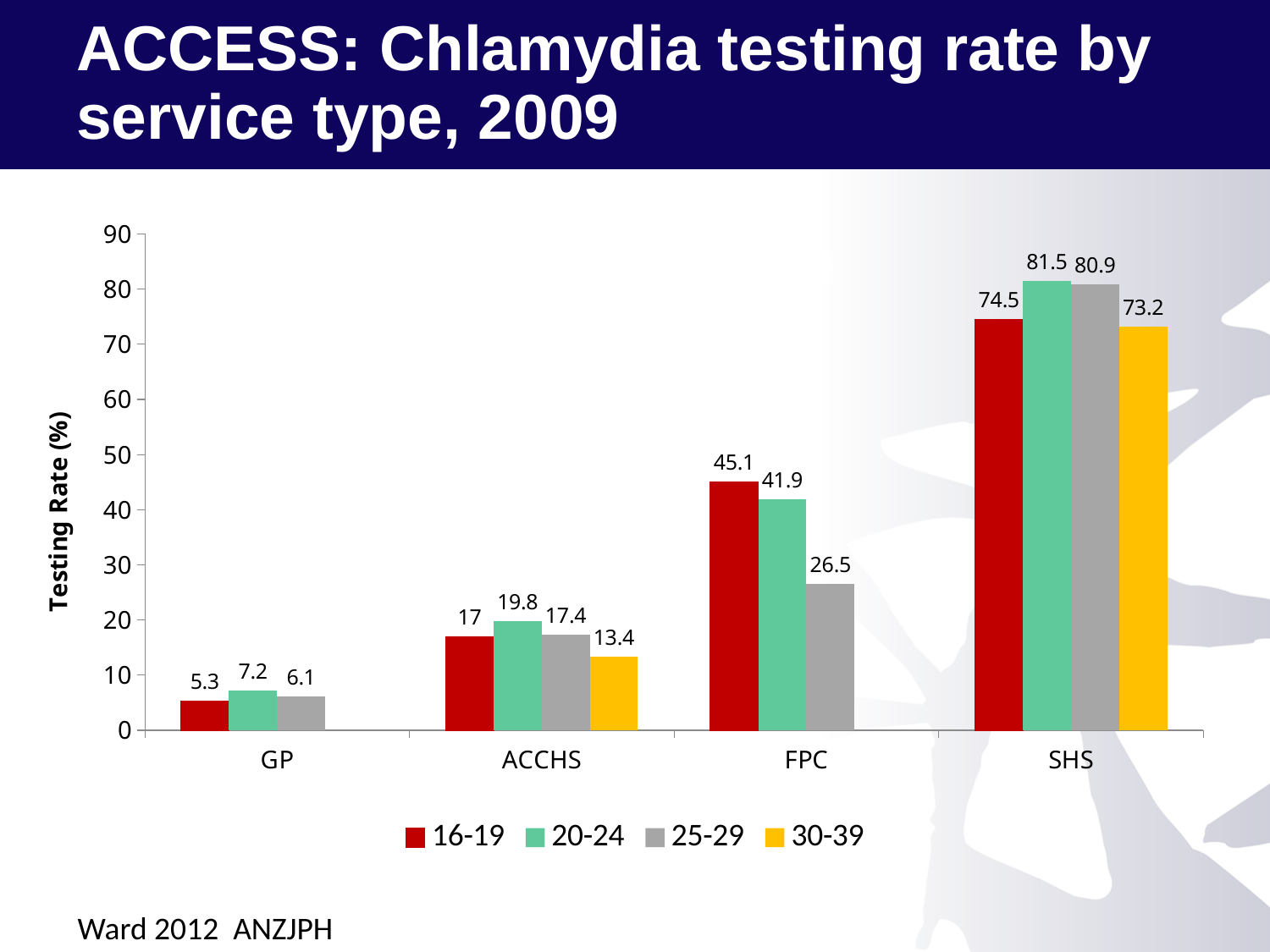
What is the testing rate for the 25-29 age group at FPC? 26.5 Which is larger at ACCHS: the testing rate for 20-24 or for 25-29? 20-24 What is the testing rate for the 16-19 age group at SHS? 74.5 Which service type has the highest testing rate for the 20-24 age group? SHS Which service type has the lowest testing rate for the 16-19 age group? GP What is the label of the y axis? Testing Rate (%) How many age groups does the legend list? 4 What is the difference between the 16-19 and 20-24 testing rates at FPC? 3.2 What type of chart is shown on the slide? Bar chart Is the testing rate for the 30-39 age group at SHS greater or less than 70? greater What is the testing rate for the 30-39 age group at ACCHS? 13.4 How many service types are shown on the x axis? 4